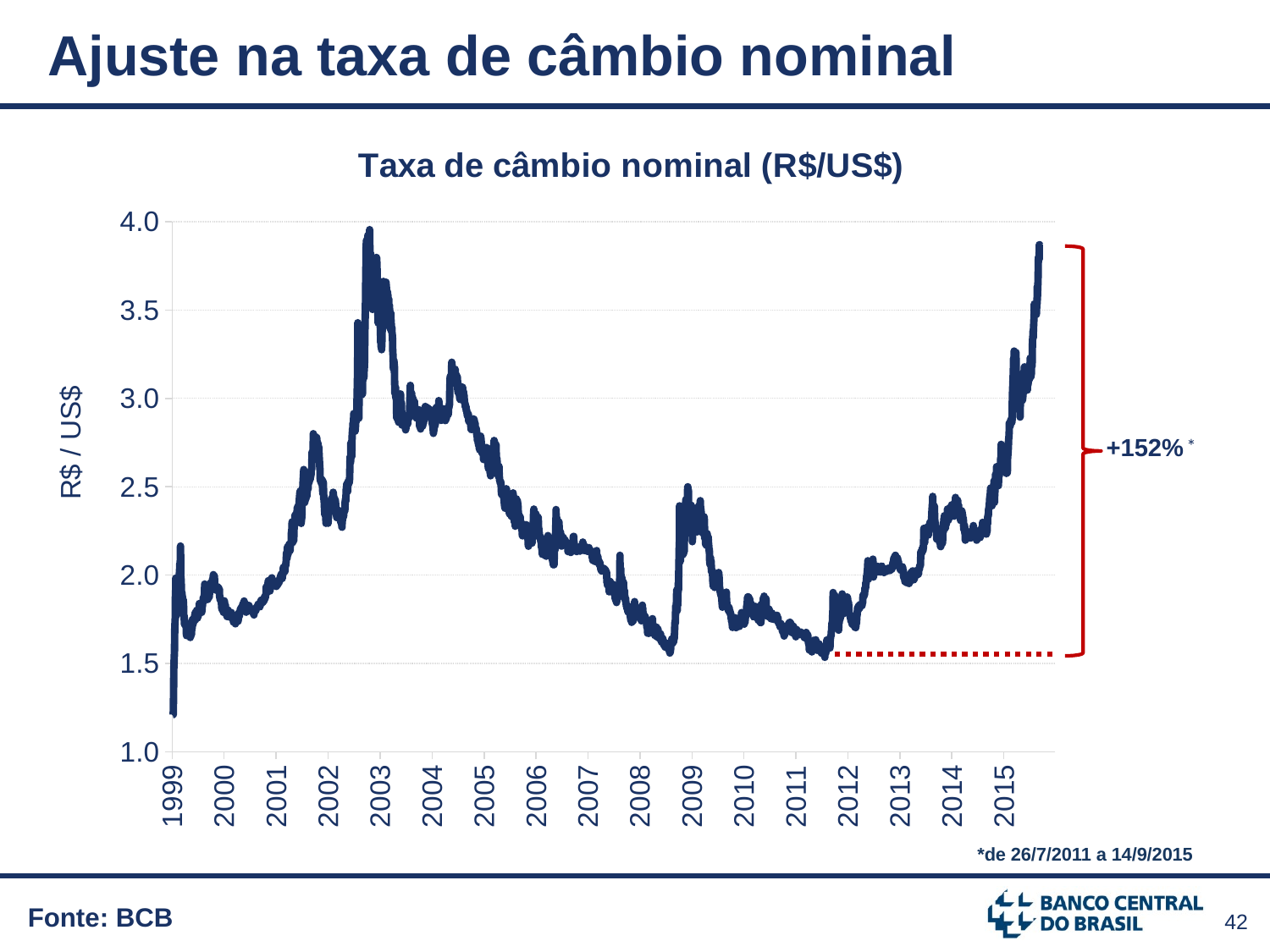
How many year labels are shown on the horizontal axis? 17 What percentage change is annotated on the right side of the chart? +152% What is the label on the vertical axis of the chart? R$ / US$ Is the exchange rate at the end of the series in 2015 greater or less than 3.5? greater In which year does the exchange rate reach its lowest point on the chart? 1999 What kind of chart is shown on the slide? line chart Is the exchange rate at the peak around the end of 2002 greater or less than 3.5? greater What is the title of the chart? Taxa de câmbio nominal (R$/US$) Does the exchange rate rise or fall between 2011 and 2015? rise Over what period does the footnote say the +152% change was measured? de 26/7/2011 a 14/9/2015 Is the exchange rate in mid-2011 greater or less than 2.0? less Does the exchange rate rise or fall between 2003 and 2008? fall